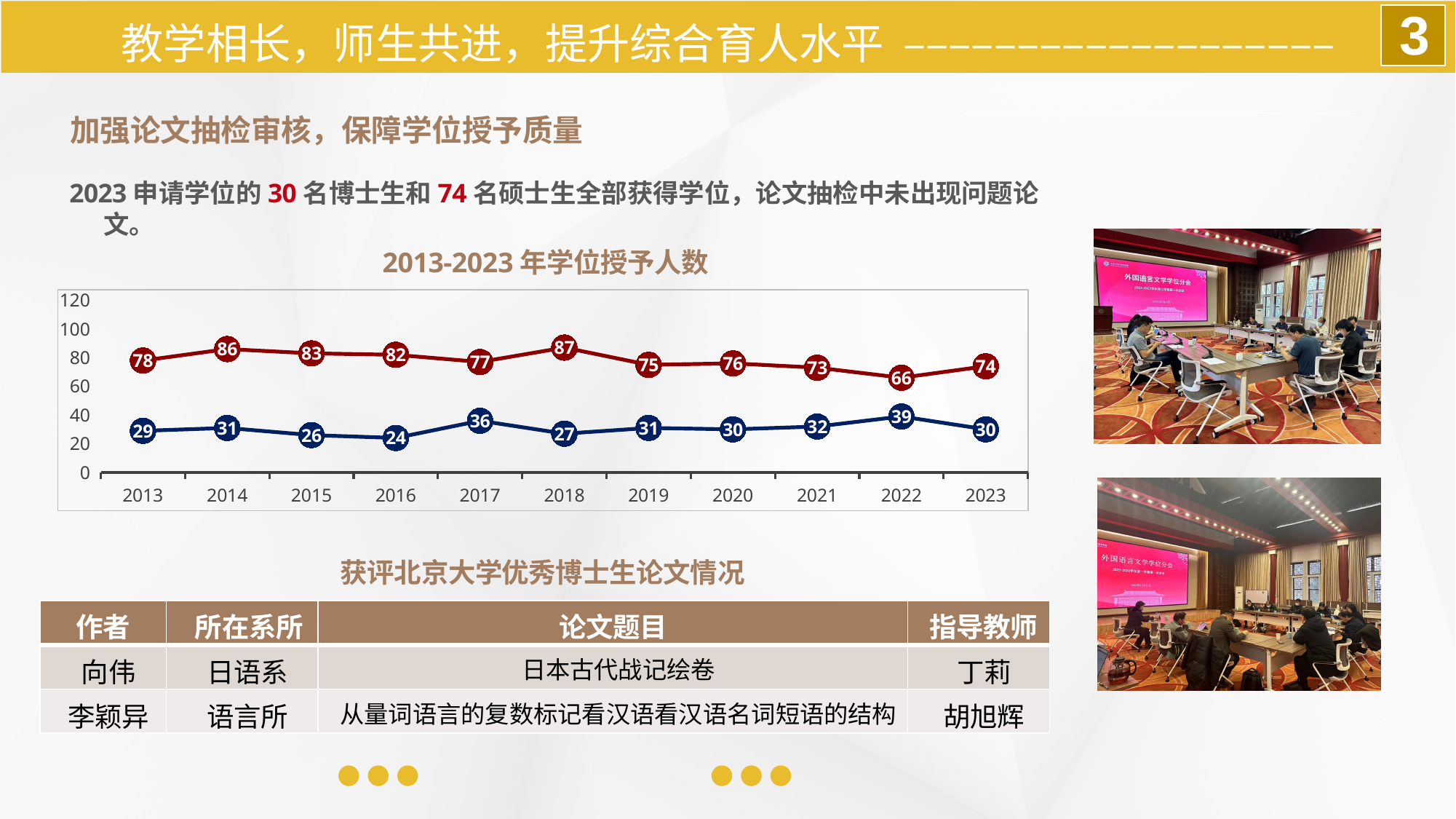
How many lines are plotted in the chart? 2 What is the value of the blue line in 2016? 24 What is the value of the red line in 2018? 87 In which year does the red line reach its highest value? 2018 Which is larger, the blue line's value in 2017 or its value in 2018? 2017 What is the title of the line chart? 2013-2023 年学位授予人数 What is the difference between the red line and the blue line in 2023? 44 In which year does the blue line reach its highest value? 2022 Does the red line rise or fall from 2018 to 2022? fall How many years are plotted along the x axis of the chart? 11 What kind of chart is used to show 2013-2023 年学位授予人数? line chart In which year does the red line reach its lowest value? 2022